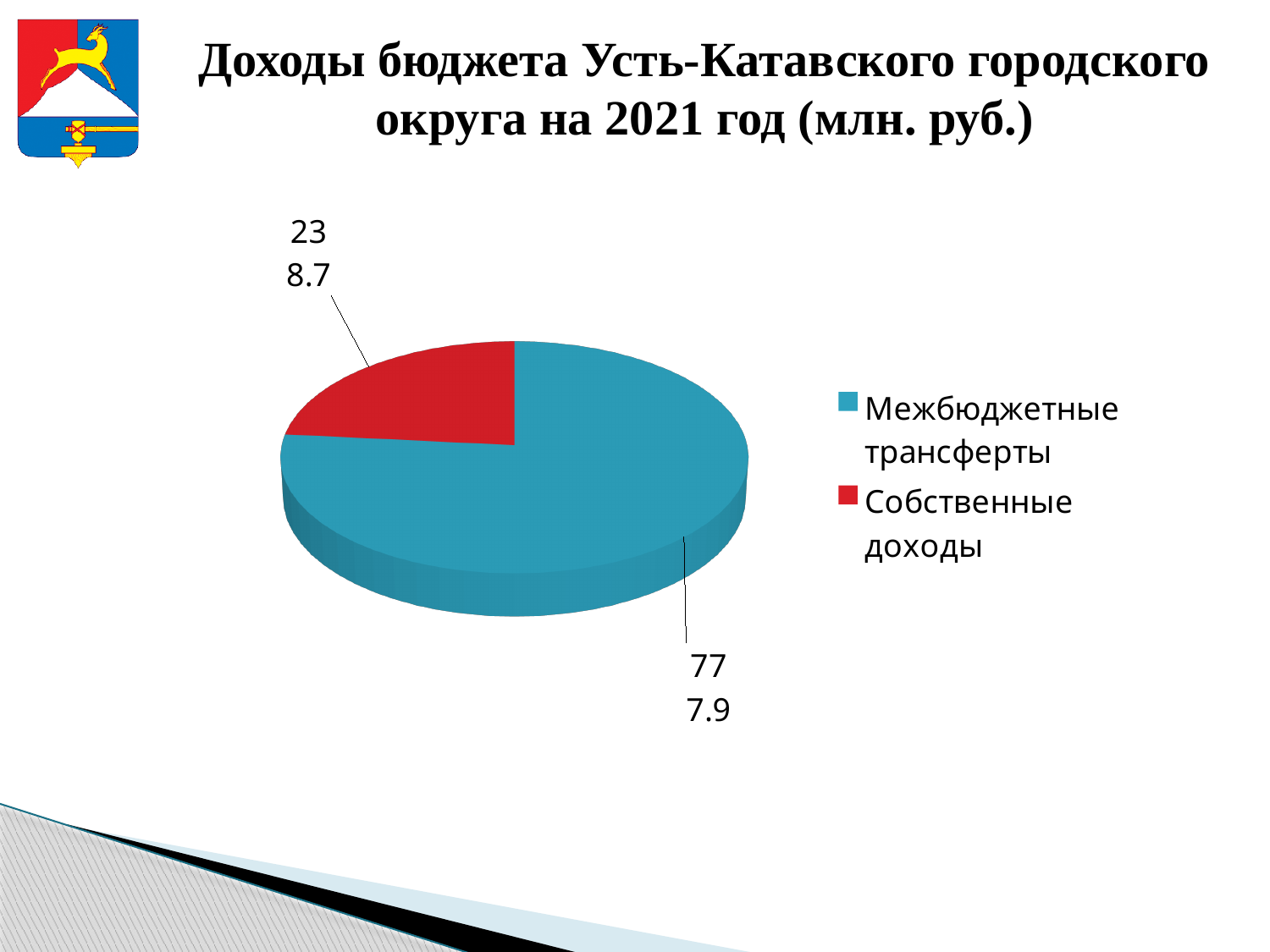
How many entries does the legend list? 2 What is the value for Межбюджетные трансферты? 777.9 What kind of chart is shown on the slide? Pie chart Which is larger, Межбюджетные трансферты or Собственные доходы? Межбюджетные трансферты What is the title of the chart on the slide? Доходы бюджета Усть-Катавского городского округа на 2021 год (млн. руб.) Which category has the largest slice of the pie? Межбюджетные трансферты What is the difference between Межбюджетные трансферты and Собственные доходы? 539.2 Which category has the smallest slice of the pie? Собственные доходы How many slices does the pie chart have? 2 What is the value for Собственные доходы? 238.7 What colour is the slice for Собственные доходы? Red What is the total of the two values shown in the pie chart? 1016.6